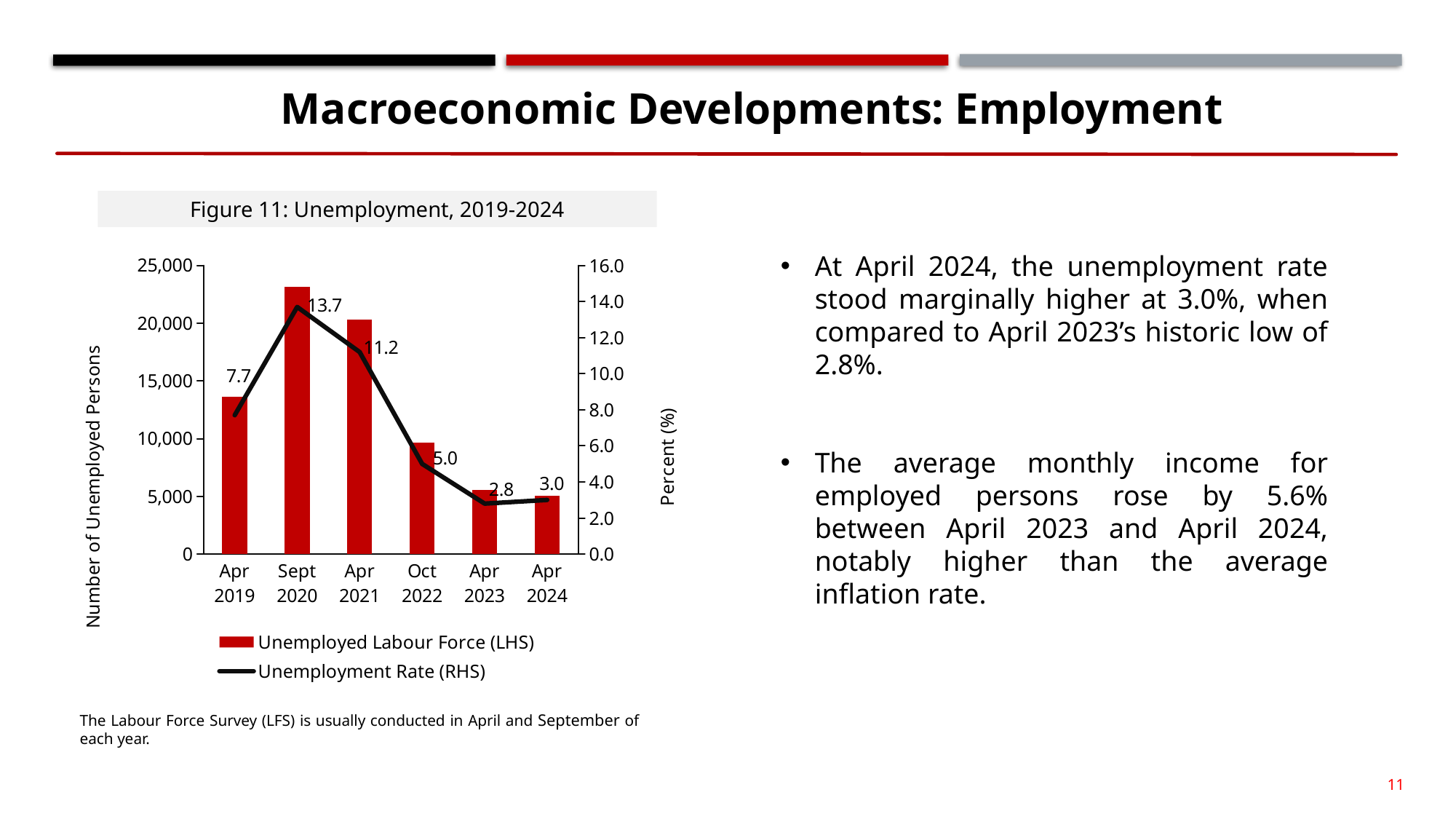
How many periods are shown on the x axis of the chart? 6 What is the unemployment rate shown for Sept 2020? 13.7 What is the unemployment rate shown for Apr 2019? 7.7 How many series does the legend list? 2 What is the unemployment rate shown for Apr 2024? 3.0 Is the number of unemployed persons in Sept 2020 greater or less than 20,000? greater What is the difference between the unemployment rate in Sept 2020 and Apr 2021? 2.5 What is the title of the figure on the slide? Figure 11: Unemployment, 2019-2024 Which period has the highest unemployment rate? Sept 2020 Which period has the lowest unemployment rate? Apr 2023 Is the unemployment rate higher in Oct 2022 or Apr 2024? Oct 2022